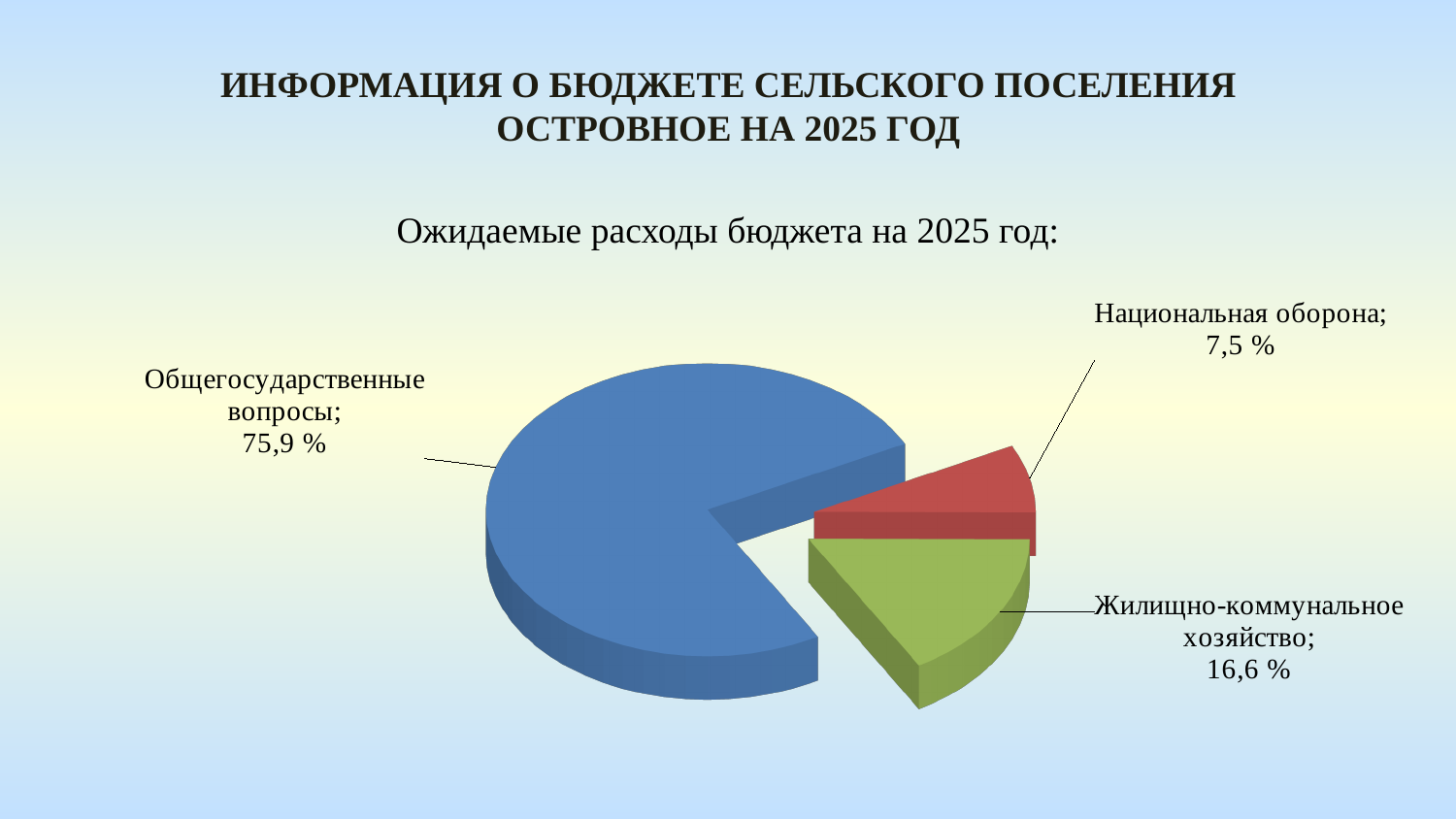
Which has a larger share: Жилищно-коммунальное хозяйство or Национальная оборона? Жилищно-коммунальное хозяйство What is the subtitle above the chart? Ожидаемые расходы бюджета на 2025 год: What share of expected 2025 budget expenditures goes to Жилищно-коммунальное хозяйство? 16,6 % What kind of chart is shown on the slide? Pie chart What is the difference in percentage points between the shares of Жилищно-коммунальное хозяйство and Национальная оборона? 9,1 What is the difference in percentage points between the shares of Общегосударственные вопросы and Жилищно-коммунальное хозяйство? 59,3 Which category has the largest share of expected 2025 budget expenditures? Общегосударственные вопросы Which category has the smallest share of expected 2025 budget expenditures? Национальная оборона How many categories are shown in the pie chart? 3 What share of expected 2025 budget expenditures goes to Национальная оборона? 7,5 % What share of expected 2025 budget expenditures goes to Общегосударственные вопросы? 75,9 % What colour is the slice for Общегосударственные вопросы? Blue